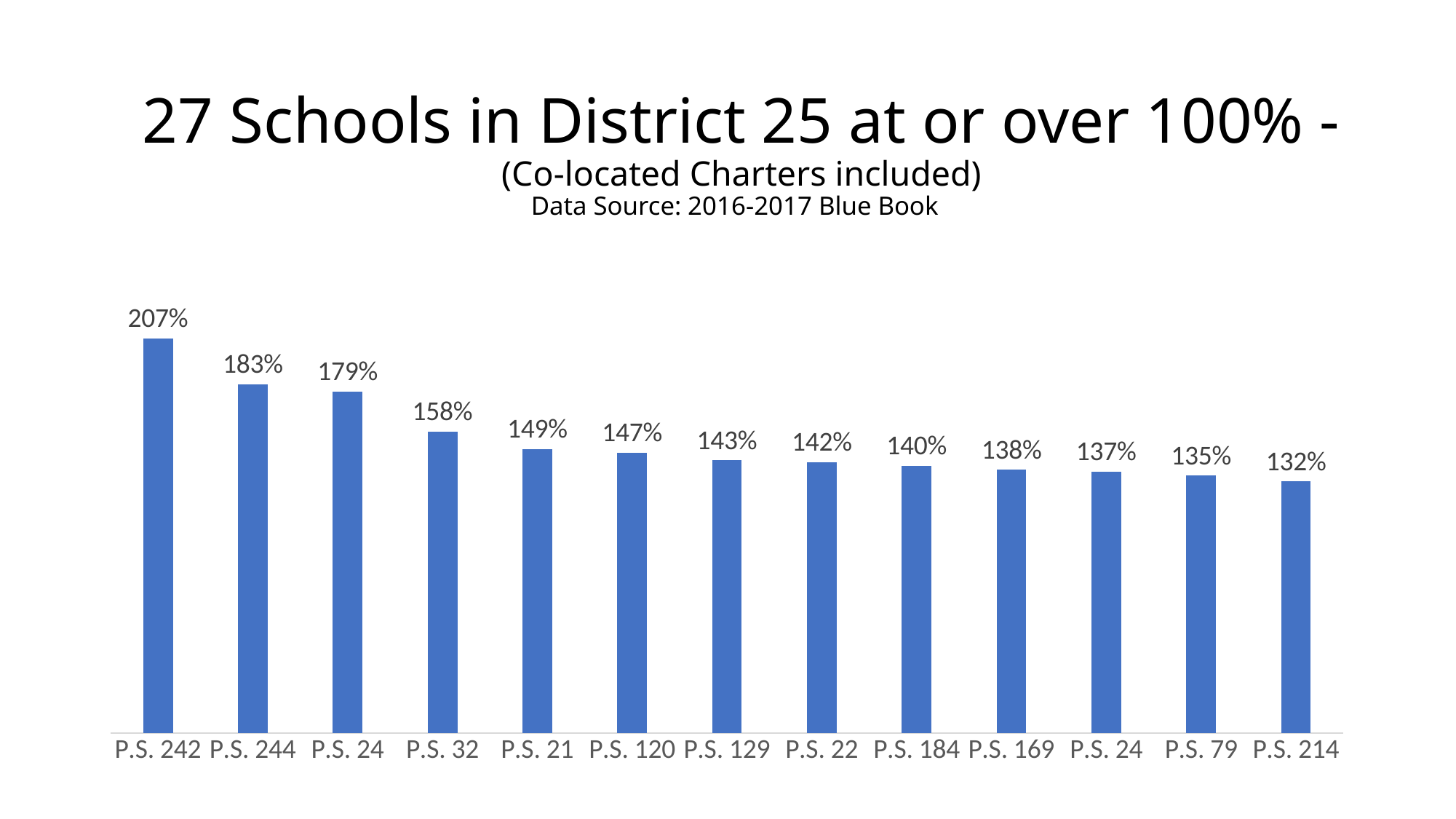
What kind of chart is shown on the slide? Bar chart Which school has the highest value in the chart? P.S. 242 What is the value shown for P.S. 32? 158% What is the difference between the values for P.S. 242 and P.S. 244? 24% Which school has the lowest value in the chart? P.S. 214 What is the value shown for P.S. 214? 132% What is the difference between the values for P.S. 21 and P.S. 79? 14% Which has a larger value, P.S. 244 or P.S. 120? P.S. 244 How many bars are shown in the chart? 13 Do the values rise or fall from left to right along the x axis? Fall What is the value shown for P.S. 242? 207% What is the value shown for P.S. 129? 143%